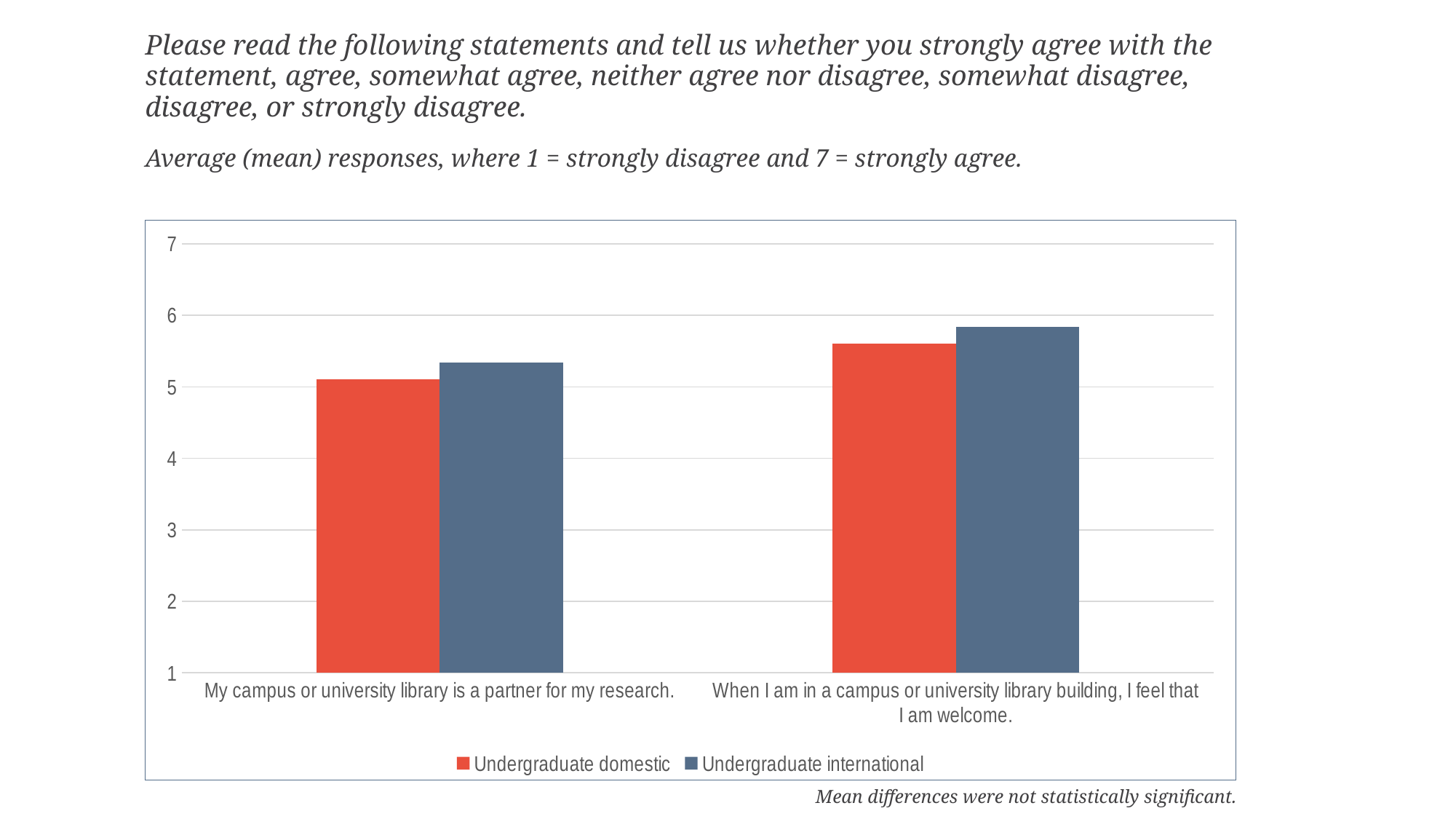
Is the Undergraduate domestic value for "When I am in a campus or university library building, I feel that I am welcome." greater or less than 5? greater How many series does the legend list? 2 Which series is shown in red in the legend? Undergraduate domestic Which series is shown in blue-grey in the legend? Undergraduate international For the statement "When I am in a campus or university library building, I feel that I am welcome.", which group has the higher mean: Undergraduate domestic or Undergraduate international? Undergraduate international Is the Undergraduate international value for "When I am in a campus or university library building, I feel that I am welcome." greater or less than 6? less Which bar is the shortest in the chart? Undergraduate domestic for "My campus or university library is a partner for my research." What kind of chart is shown on the slide? Bar chart For the statement "My campus or university library is a partner for my research.", which group has the higher mean: Undergraduate domestic or Undergraduate international? Undergraduate international Is the Undergraduate international value for "My campus or university library is a partner for my research." greater or less than 6? less Which bar is the tallest in the chart? Undergraduate international for "When I am in a campus or university library building, I feel that I am welcome." How many statements (categories) are plotted on the x axis? 2